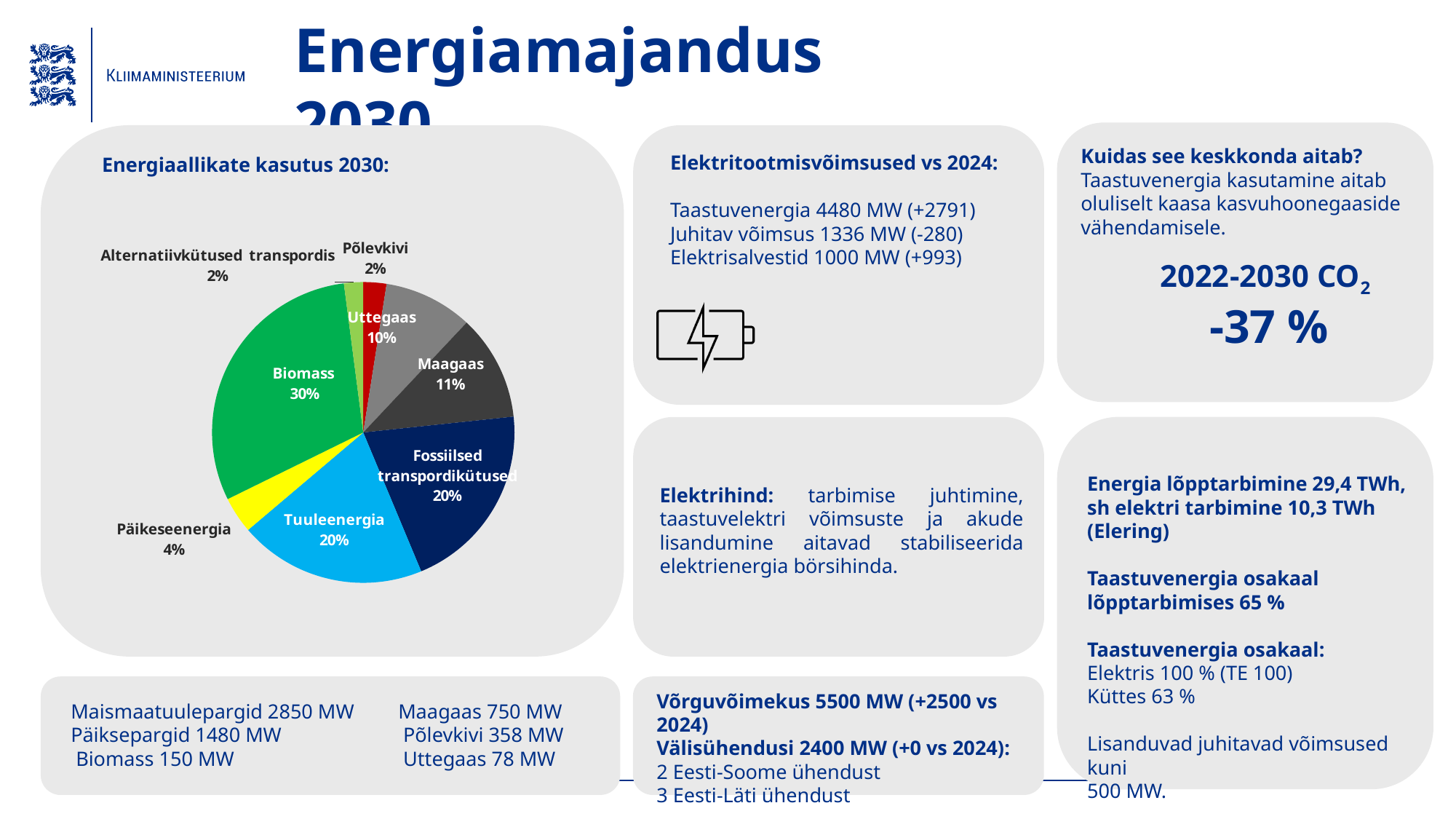
Which is larger, the share of Maagaas or the share of Uttegaas? Maagaas What colour is the Tuuleenergia slice? light blue What is the title of the chart? Energiaallikate kasutus 2030: What share of the pie does Biomass have? 30% What kind of chart is shown on the slide? pie chart What is the value shown for Põlevkivi? 2% Which category has the largest share of the pie? Biomass What is the difference between the shares of Biomass and Uttegaas? 20% What is the value shown for Tuuleenergia? 20% What is the value shown for Maagaas? 11% How many slices does the pie chart have? 8 What is the value shown for Päikeseenergia? 4%